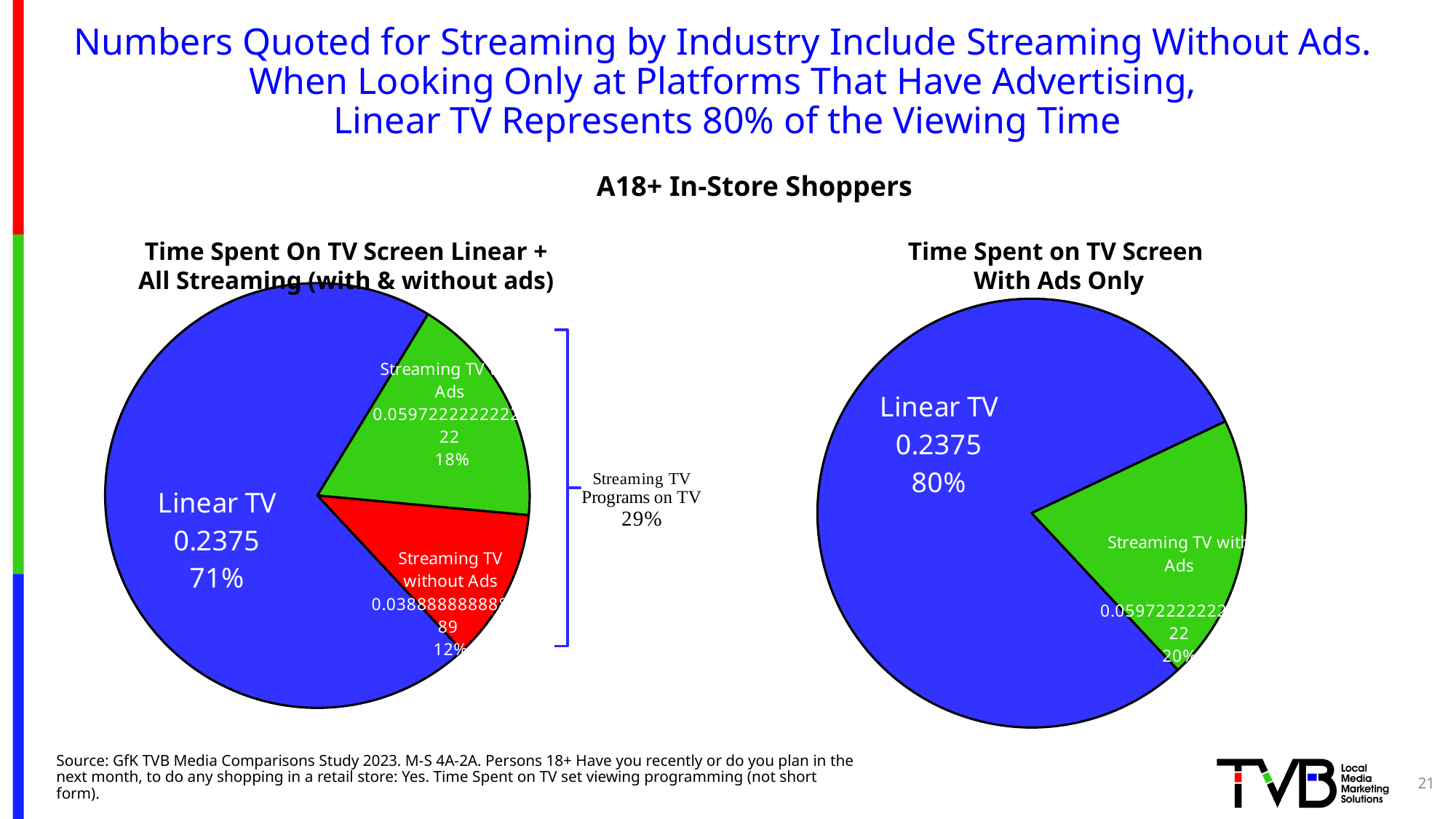
In the left pie chart (Linear + All Streaming), which slice is the smallest? Streaming TV without Ads In the right pie chart (With Ads Only), which slice is larger, Linear TV or Streaming TV with Ads? Linear TV In the left pie chart (Linear + All Streaming), what percentage share does Streaming TV without Ads have? 12% In the left pie chart (Linear + All Streaming), what value is shown for Linear TV? 0.2375 In the left pie chart (Linear + All Streaming), what percentage share does Linear TV have? 71% How many slices does the right pie chart (With Ads Only) have? 2 What type of chart is used on the left, titled 'Time Spent On TV Screen Linear + All Streaming (with & without ads)'? Pie chart What colour is the Linear TV slice in both pie charts? Blue In the right pie chart (With Ads Only), what percentage share does Streaming TV with Ads have? 20% How many slices does the left pie chart (Linear + All Streaming) have? 3